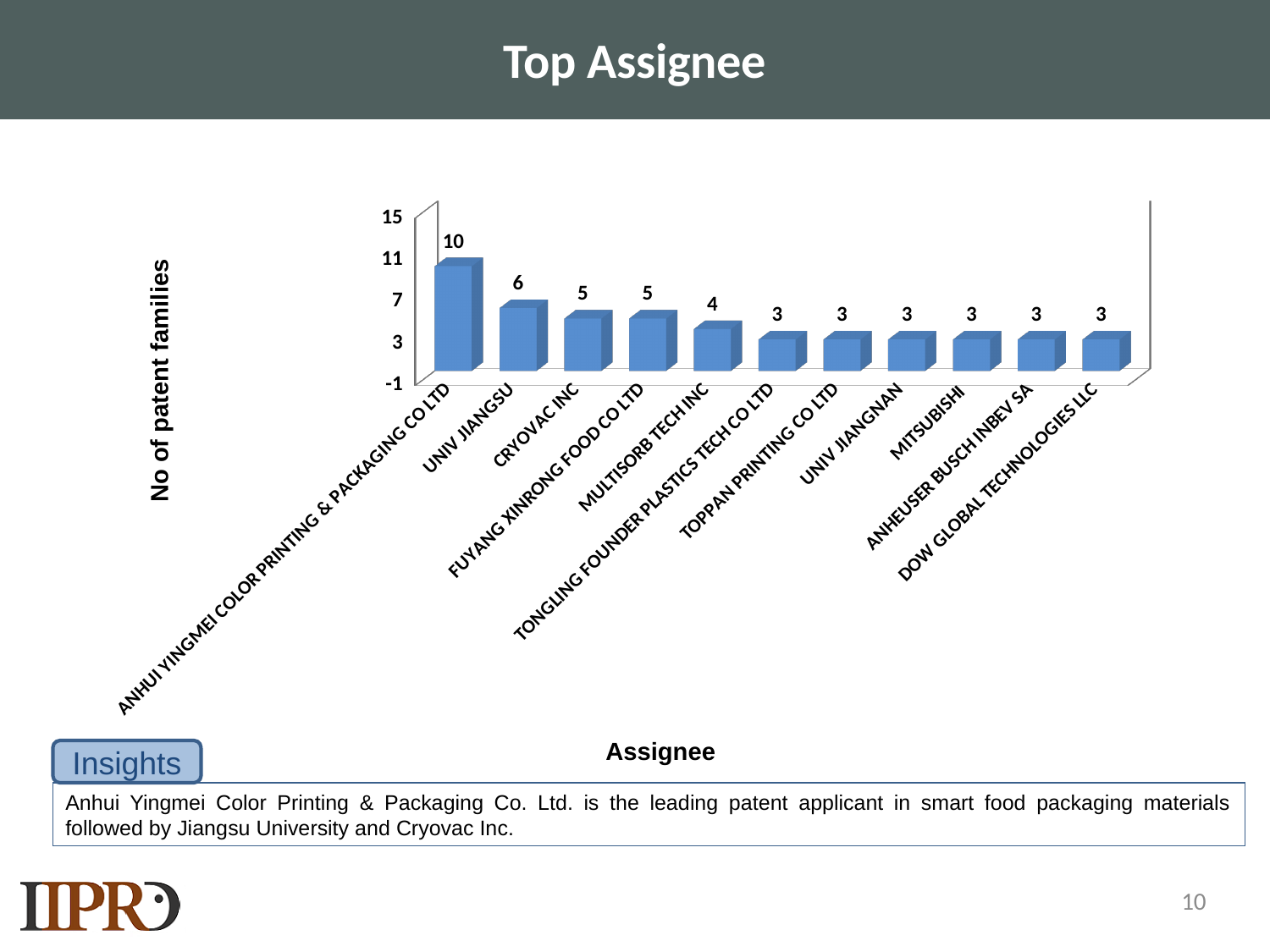
How many patent families does ANHUI YINGMEI COLOR PRINTING & PACKAGING CO LTD have? 10 Which assignee has the highest number of patent families? ANHUI YINGMEI COLOR PRINTING & PACKAGING CO LTD How many patent families does CRYOVAC INC have? 5 What is the difference in patent families between ANHUI YINGMEI COLOR PRINTING & PACKAGING CO LTD and UNIV JIANGSU? 4 How many assignees are shown on the chart? 11 What is the value shown for MULTISORB TECH INC? 4 Do the values rise or fall from left to right along the x axis? Fall What is the label of the vertical axis? No of patent families What type of chart is shown on the slide? Bar chart What is the difference between the values for UNIV JIANGSU and MULTISORB TECH INC? 2 Which has more patent families, CRYOVAC INC or MITSUBISHI? CRYOVAC INC What is the number of patent families for UNIV JIANGSU? 6